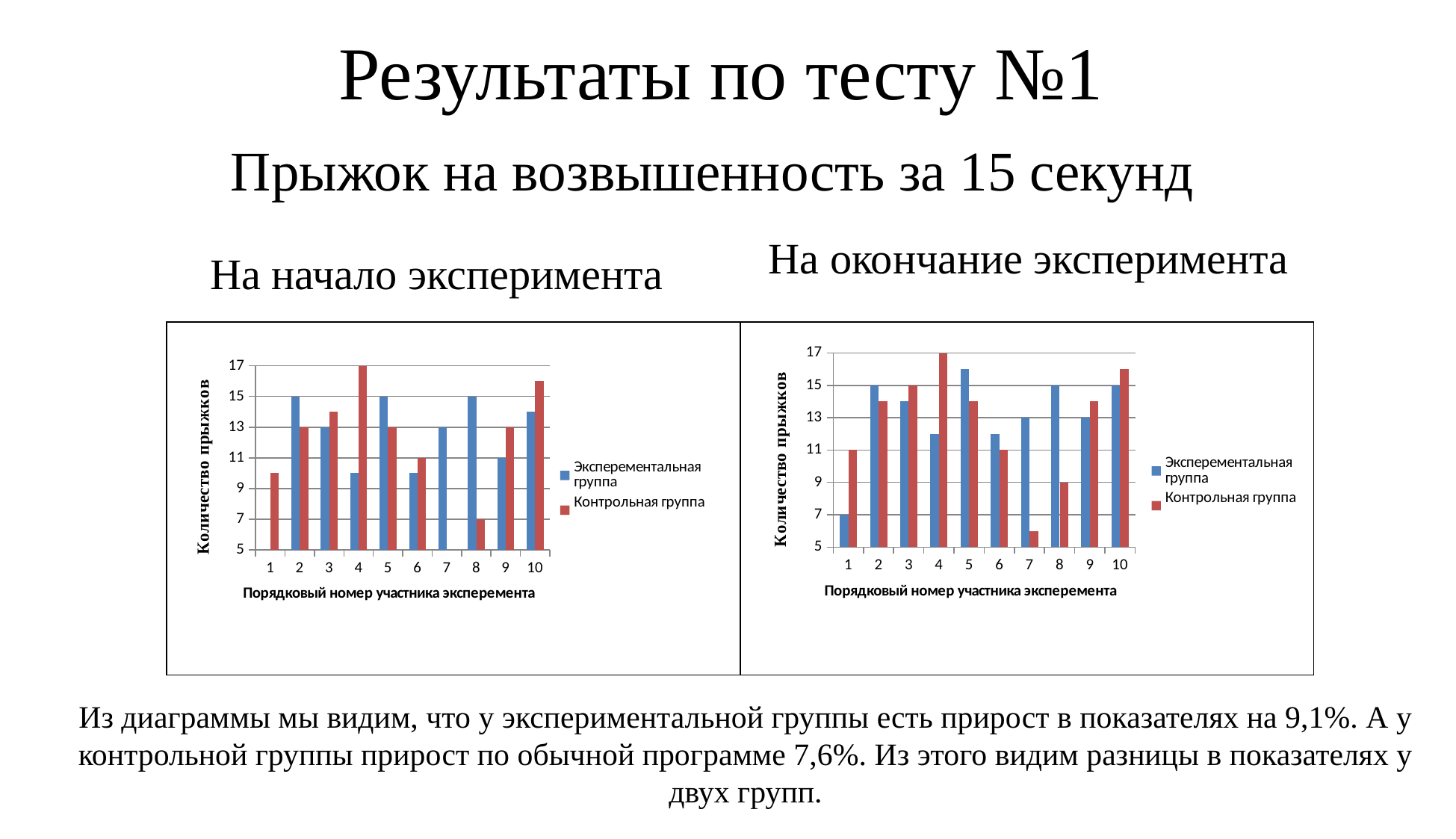
In the left chart (На начало эксперимента), what is the difference between the Экспериментальная группа and Контрольная группа values for participant 2? 2 In the right chart (На окончание эксперимента), is the Контрольная группа value for participant 8 greater or less than 11? less What is the title of the vertical axis on the charts? Количество прыжков How many participants (categories) are shown on the x axis of the right chart (На окончание эксперимента)? 10 What kind of chart is used on the slide for the test results? bar chart In the right chart (На окончание эксперимента), what is the value for participant 1 in the Экспериментальная группа series? 7 How many series does the legend of the left chart (На начало эксперимента) list? 2 In the left chart (На начало эксперимента), which participant has the highest value in the Контрольная группа series? 4 In the right chart (На окончание эксперимента), which participant has the lowest value in the Контрольная группа series? 7 In the left chart (На начало эксперимента), what is the value for participant 2 in the Экспериментальная группа series? 15 In the left chart (На начало эксперимента), what is the value for participant 4 in the Контрольная группа series? 17 In the left chart (На начало эксперимента), for participant 4, which series has the larger value: Экспериментальная группа or Контрольная группа? Контрольная группа